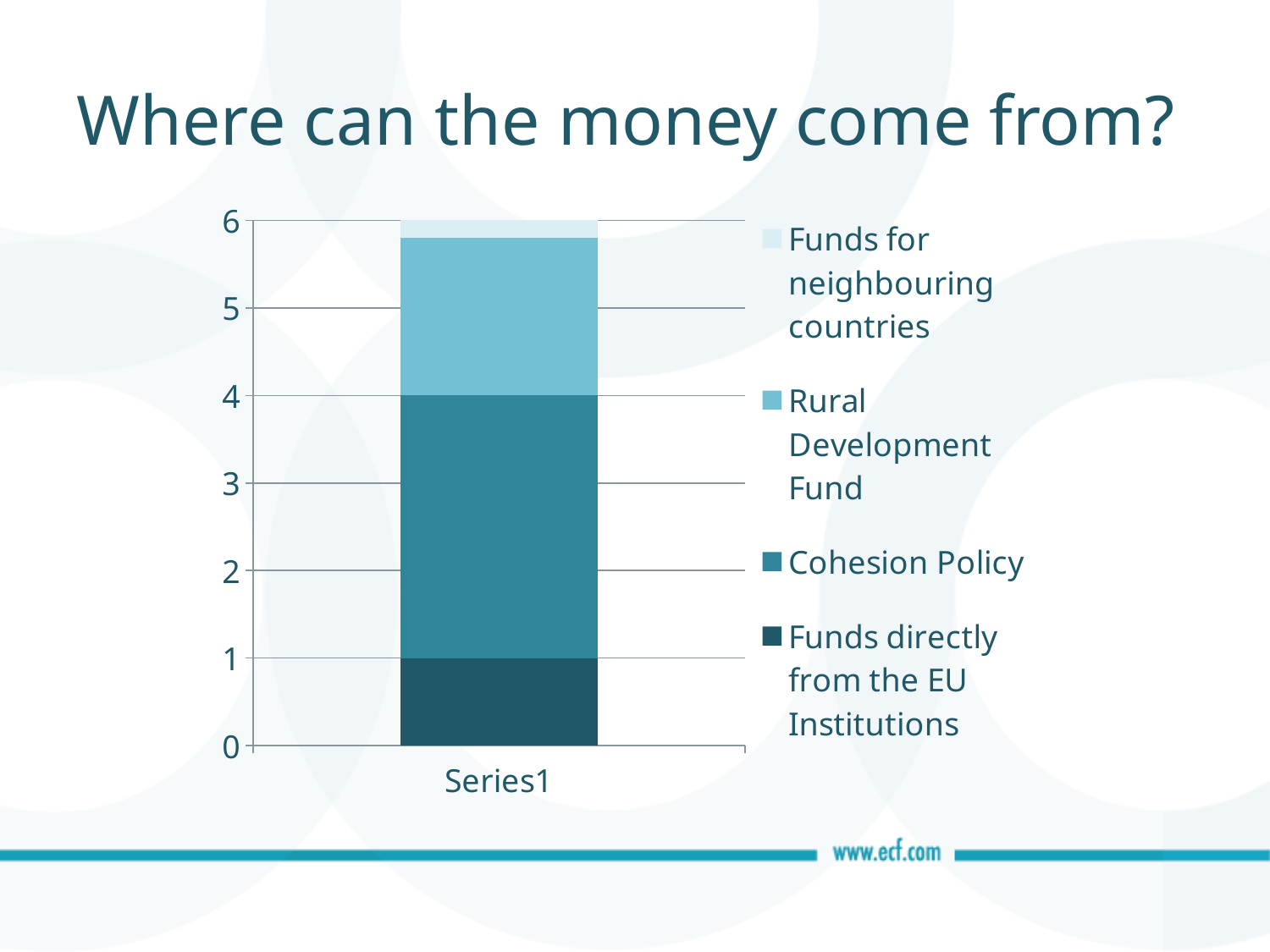
How many categories are plotted on the x axis? 1 Which series has the largest segment in the stacked bar? Cohesion Policy How many series does the legend list? 4 Is the value for Funds for neighbouring countries greater or less than 1? less Which series forms the bottom segment of the stacked bar? Funds directly from the EU Institutions Which segment is larger, Rural Development Fund or Funds directly from the EU Institutions? Rural Development Fund Which series has the smallest segment in the stacked bar? Funds for neighbouring countries What is the title of the slide containing the chart? Where can the money come from? What is the label of the category on the x axis? Series1 What kind of chart is shown on the slide? bar chart Is the value for Cohesion Policy greater or less than 2? greater Is the total height of the stacked bar greater or less than 5? greater